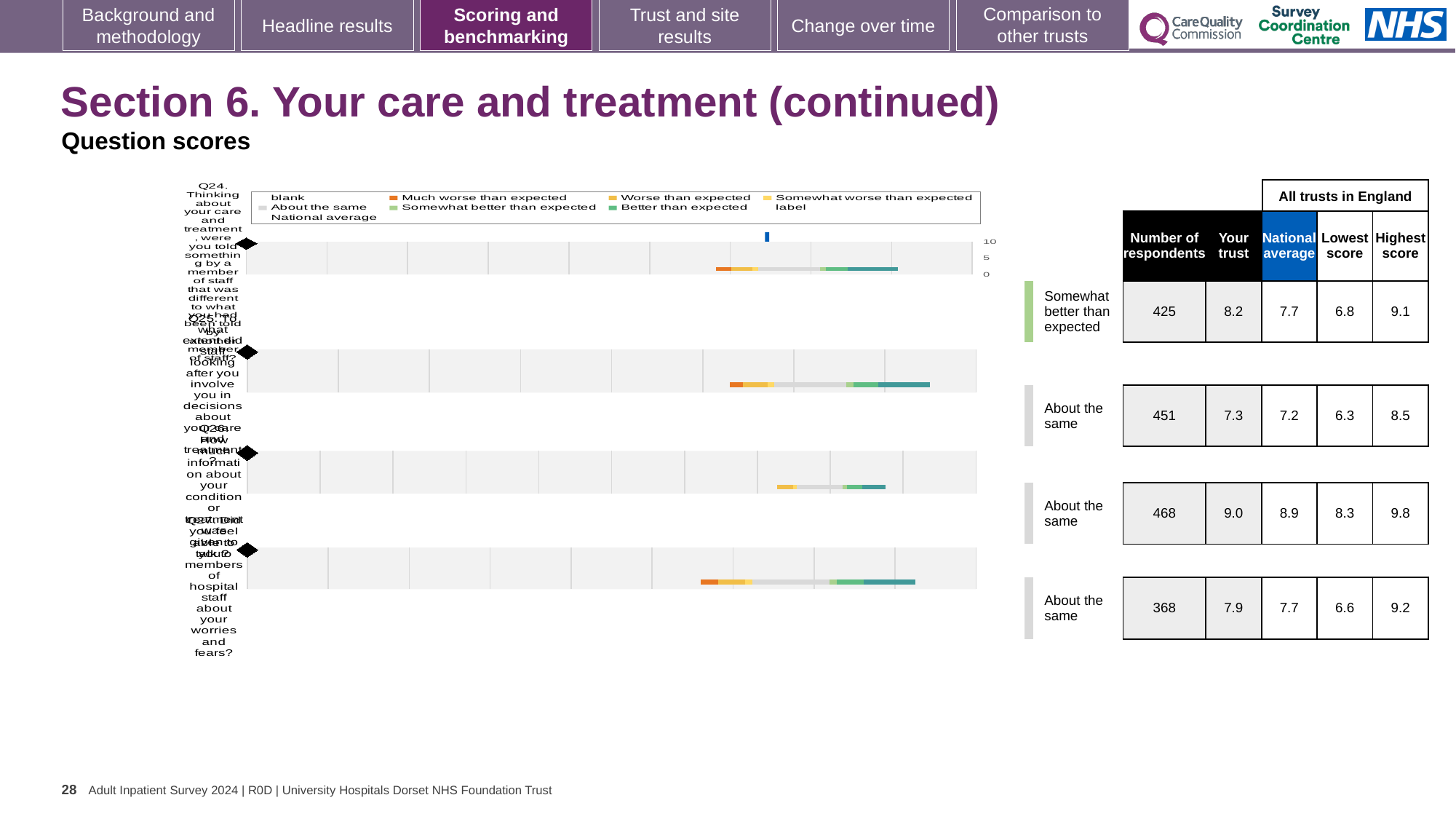
In the table next to the top chart (Q24), what is the national average? 7.7 What kind of chart is used to show the question scores on this slide? bar chart For the top chart (Q24), what is the difference between the 'Your trust' score and the national average? 0.5 How many respondents are listed for the third chart (Q26)? 468 How many question charts (Q24 to Q27) are shown on the slide? 4 For the bottom chart (Q27), which is larger: the 'Your trust' score or the national average? Your trust What is the highest score listed for the bottom chart (Q27)? 9.2 What benchmark category is given for the top chart (Q24)? Somewhat better than expected In the table next to the top chart (Q24), what is the 'Your trust' score? 8.2 Which of the four questions has the highest 'Your trust' score? the third (Q26), 9.0 Which of the four questions has the lowest 'Lowest score' value? the second (Q25), 6.3 In the table next to the second chart (Q25), what is the national average? 7.2